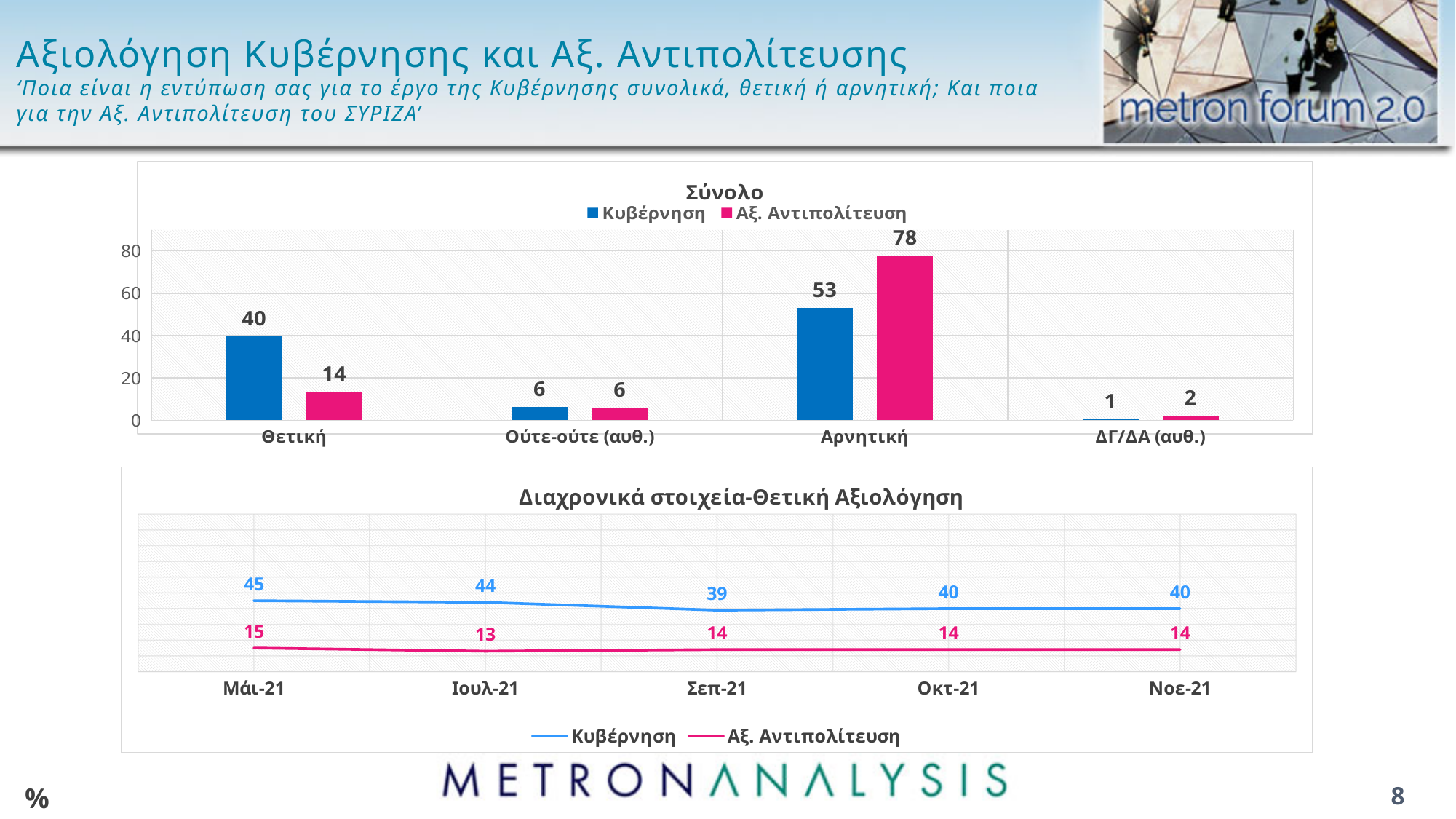
In the 'Σύνολο' chart, which category has the lowest value for Κυβέρνηση? ΔΓ/ΔΑ (αυθ.) In the 'Σύνολο' chart, how many categories are shown on the x axis? 4 In the 'Σύνολο' chart, which category has the highest value for Αξ. Αντιπολίτευση? Αρνητική How many series does the legend of the 'Διαχρονικά στοιχεία-Θετική Αξιολόγηση' chart list? 2 In the 'Σύνολο' chart, which series has the larger value in the Θετική category? Κυβέρνηση In the 'Σύνολο' chart, what is the difference between the Αξ. Αντιπολίτευση and Κυβέρνηση values in the Αρνητική category? 25 In the 'Διαχρονικά στοιχεία-Θετική Αξιολόγηση' chart, what is the value for Κυβέρνηση in Σεπ-21? 39 In the 'Διαχρονικά στοιχεία-Θετική Αξιολόγηση' chart, what is the value for Αξ. Αντιπολίτευση in Ιουλ-21? 13 In the 'Σύνολο' chart, what is the value for Αξ. Αντιπολίτευση in the Αρνητική category? 78 In the 'Διαχρονικά στοιχεία-Θετική Αξιολόγηση' chart, does the Κυβέρνηση line rise or fall from Μάι-21 to Νοε-21? Fall What kind of chart is the 'Σύνολο' chart? Bar chart In the 'Σύνολο' chart, what is the value for Κυβέρνηση in the Θετική category? 40